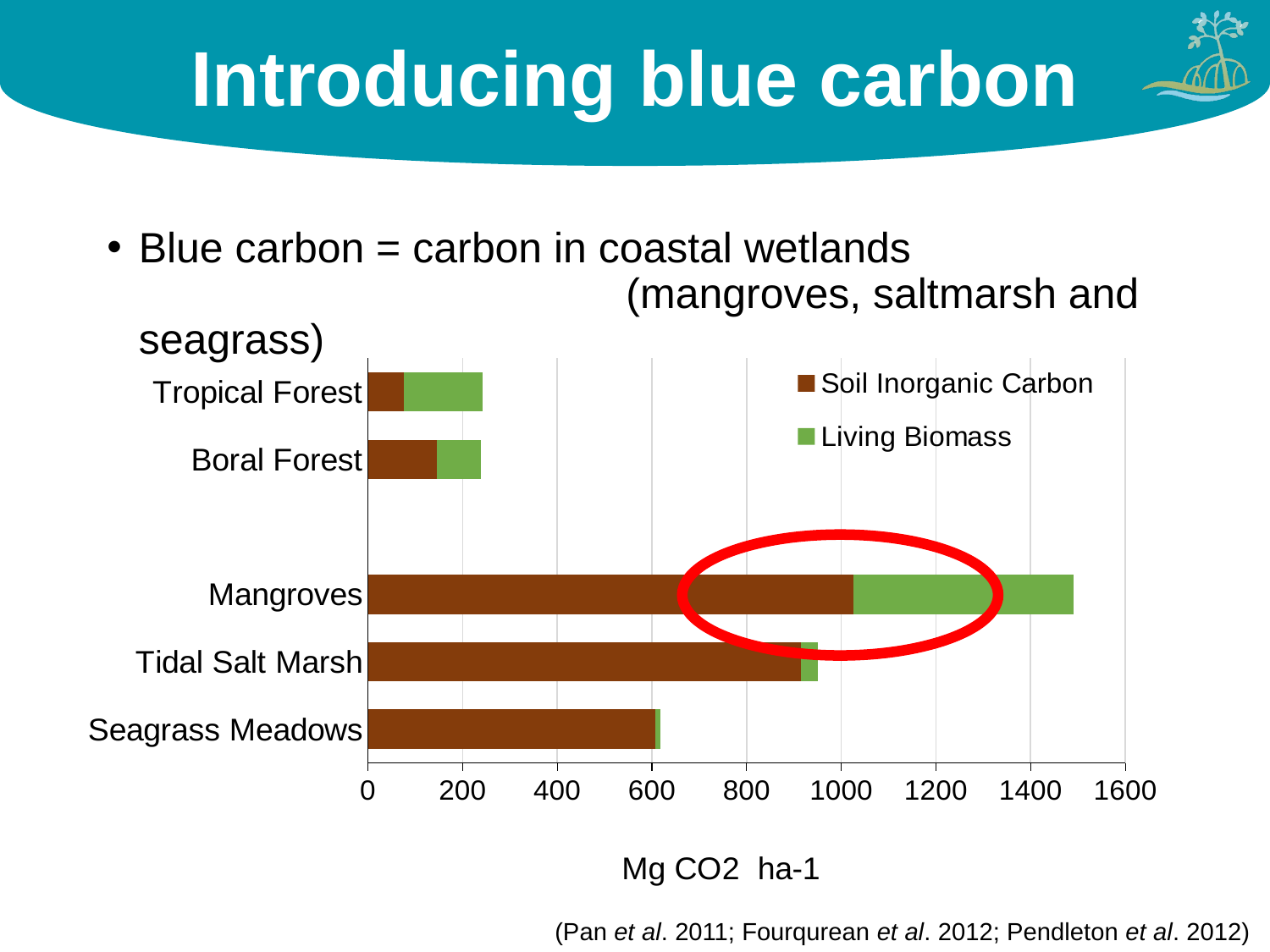
Which series is shown in green in the chart's legend? Living Biomass Is the total value for Mangroves greater or less than 1400? greater What kind of chart is shown on the slide? stacked bar chart Is the total value for Seagrass Meadows greater or less than 800? less Which has the larger total value, Mangroves or Tidal Salt Marsh? Mangroves Which has the larger total value, Seagrass Meadows or Tidal Salt Marsh? Tidal Salt Marsh How many categories are plotted on the chart? 5 What unit is shown on the x axis label of the chart? Mg CO2 ha-1 Is the total value for Tidal Salt Marsh greater or less than 800? greater Which category has the highest total value on the chart? Mangroves How many series does the chart's legend list? 2